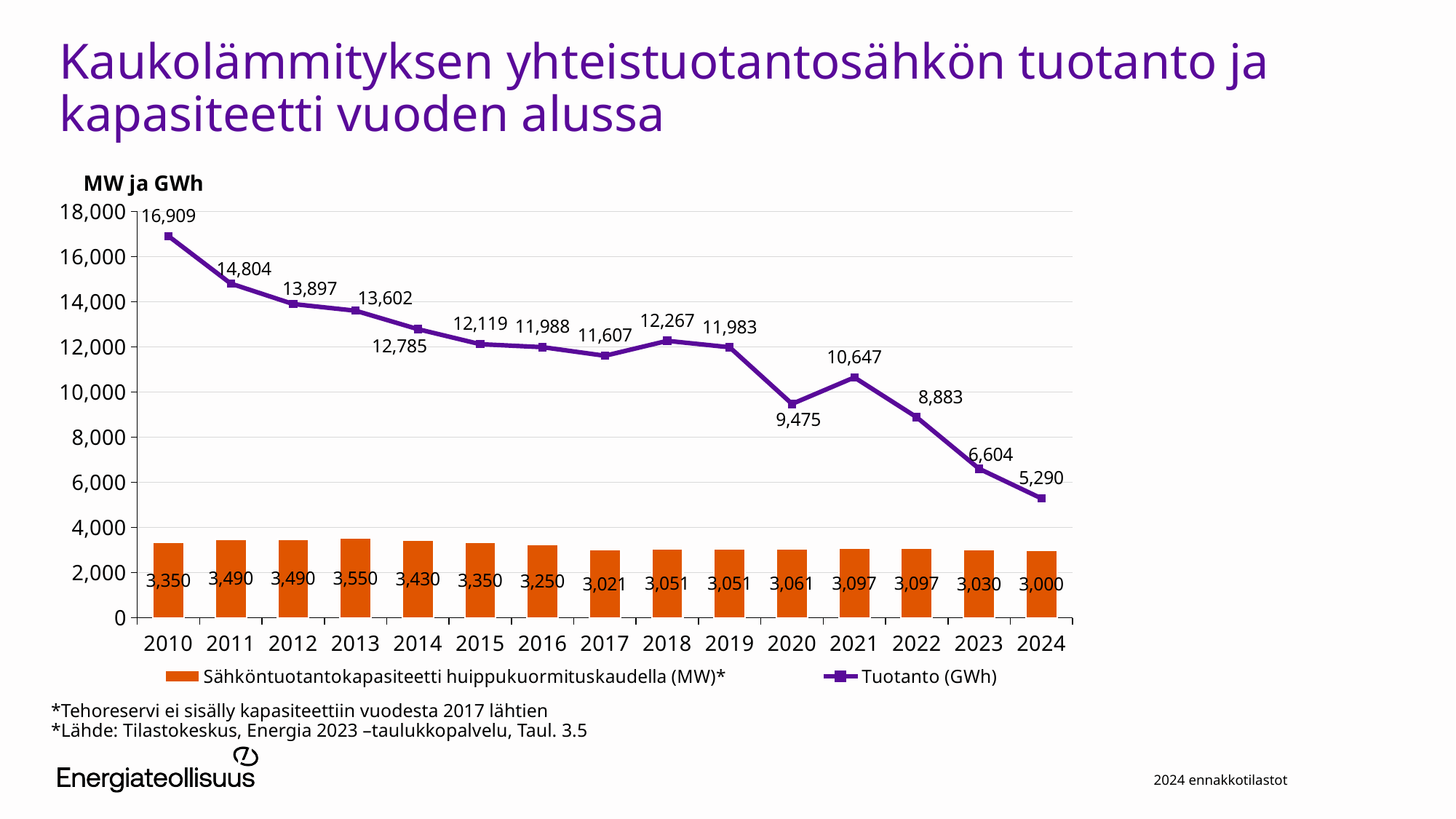
What was the Sähköntuotantokapasiteetti huippukuormituskaudella (MW) value in 2013? 3,550 What is the overall trend of Tuotanto (GWh) from 2010 to 2024? falling In which year was Sähköntuotantokapasiteetti huippukuormituskaudella (MW) the highest? 2013 What was the Tuotanto (GWh) value in 2010? 16,909 How many years are shown on the x axis of the chart? 15 What was the Tuotanto (GWh) value in 2020? 9,475 Is the Tuotanto (GWh) value for 2021 greater or less than 10,000? greater What is the difference between the Tuotanto (GWh) values for 2010 and 2024? 11,619 Which year had a higher Tuotanto (GWh) value, 2018 or 2019? 2018 What colour are the bars representing Sähköntuotantokapasiteetti huippukuormituskaudella (MW)? orange In which year was Tuotanto (GWh) the lowest? 2024 How many series does the legend list? 2